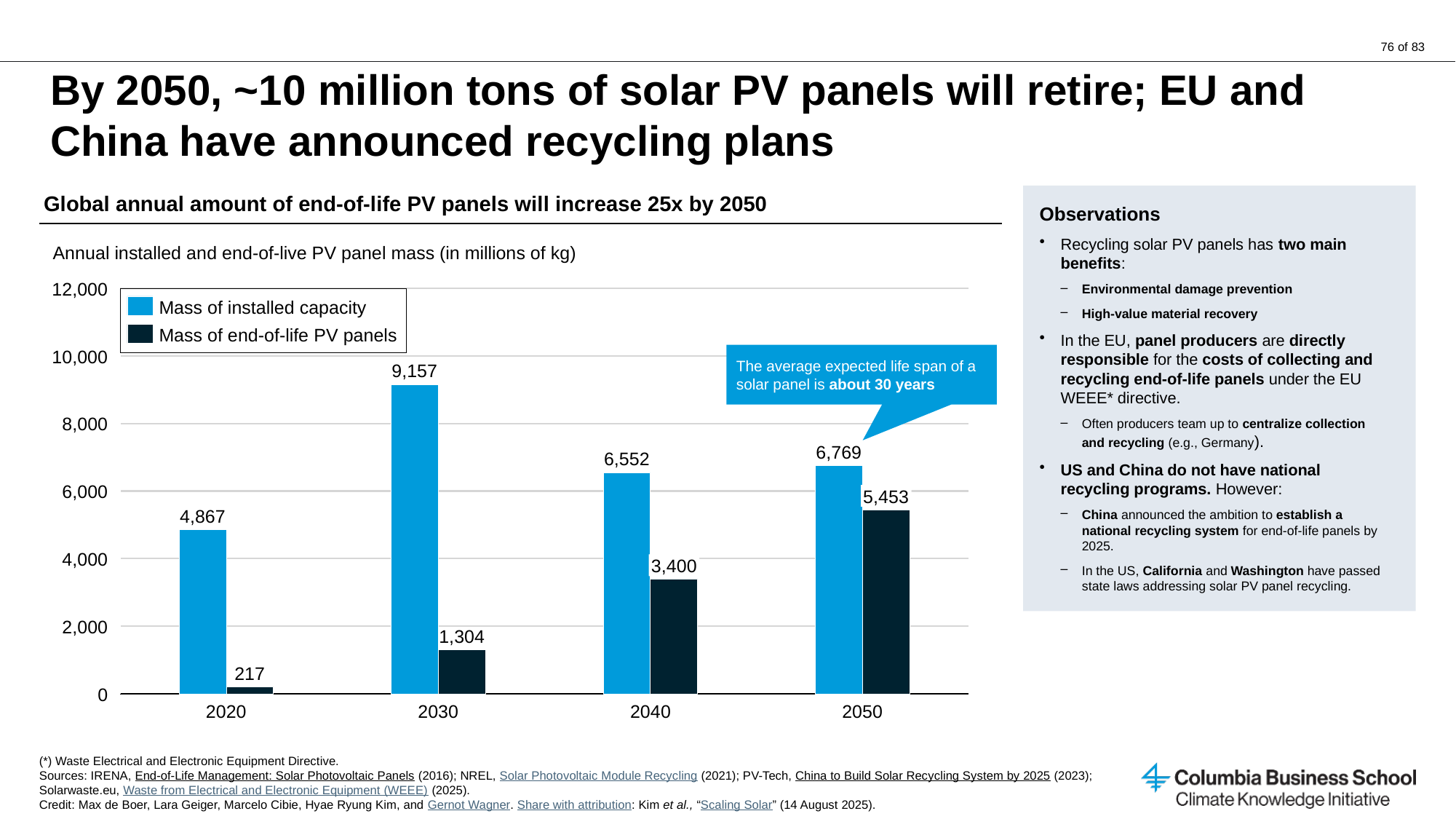
What is the mass of end-of-life PV panels in 2050? 5,453 What is the mass of end-of-life PV panels in 2020? 217 What is the difference between the mass of installed capacity and the mass of end-of-life PV panels in 2040? 3,152 According to the callout on the chart, what is the average expected life span of a solar panel? About 30 years Does the mass of end-of-life PV panels rise or fall from 2020 to 2050? Rise How many series does the chart legend list? 2 In which year is the mass of installed capacity highest? 2030 In which year is the mass of end-of-life PV panels lowest? 2020 What is the mass of installed capacity in 2030? 9,157 What kind of chart is shown on the slide? Bar chart How many years are shown on the x axis of the chart? 4 Which is larger in 2050: the mass of installed capacity or the mass of end-of-life PV panels? Mass of installed capacity